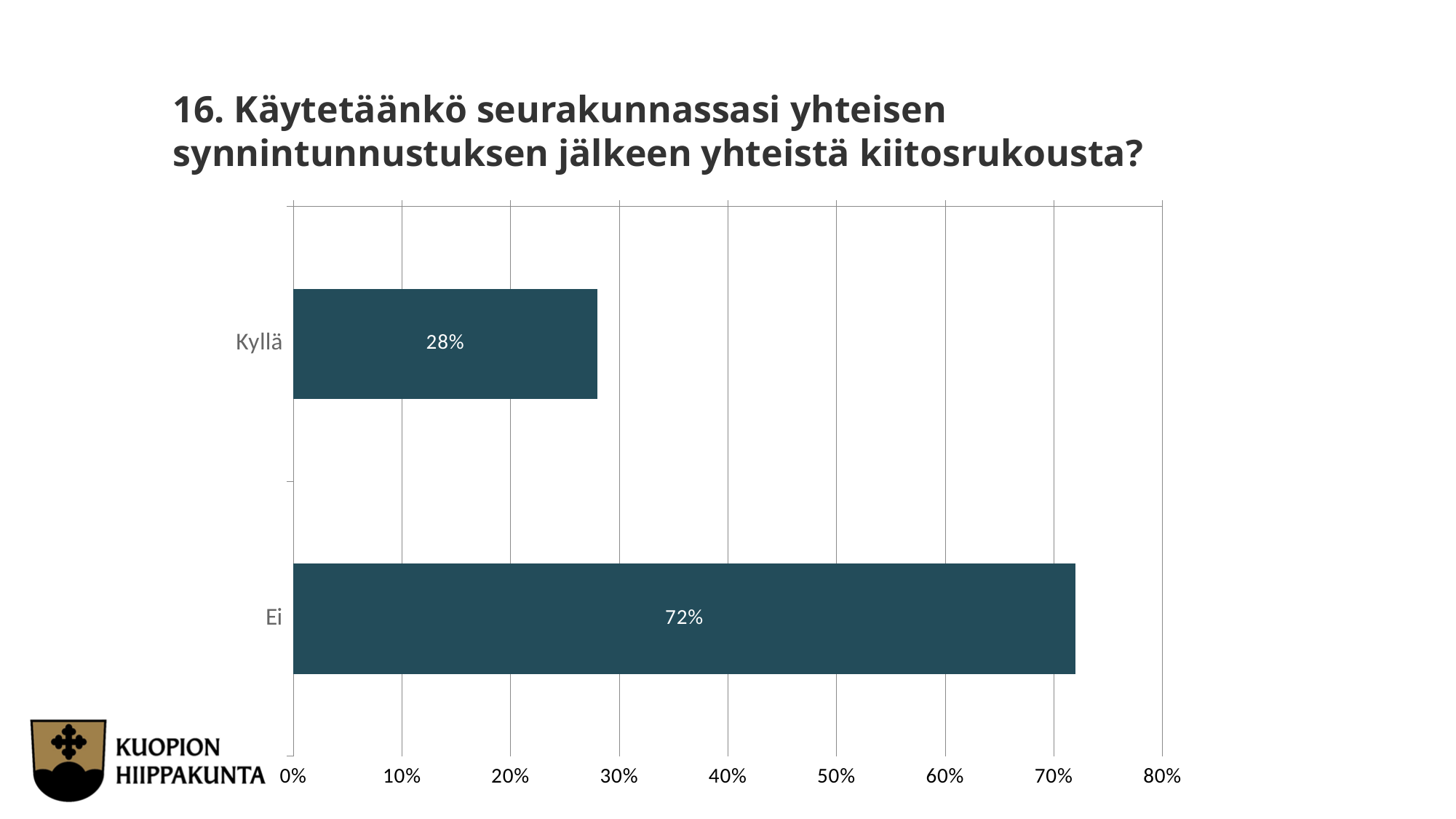
What is the value for Ei? 72% Which category has the highest value? Ei What kind of chart is shown on the slide? bar chart Is the value for Kyllä greater or less than 30%? less What is the highest value shown on the x axis? 80% Is the value for Ei greater or less than 70%? greater Which category has the lowest value? Kyllä How many categories are shown in the chart? 2 What is the value for Kyllä? 28% What is the total of the values for Kyllä and Ei? 100% Which is larger, the value for Kyllä or the value for Ei? Ei What is the difference between the values for Ei and Kyllä? 44%